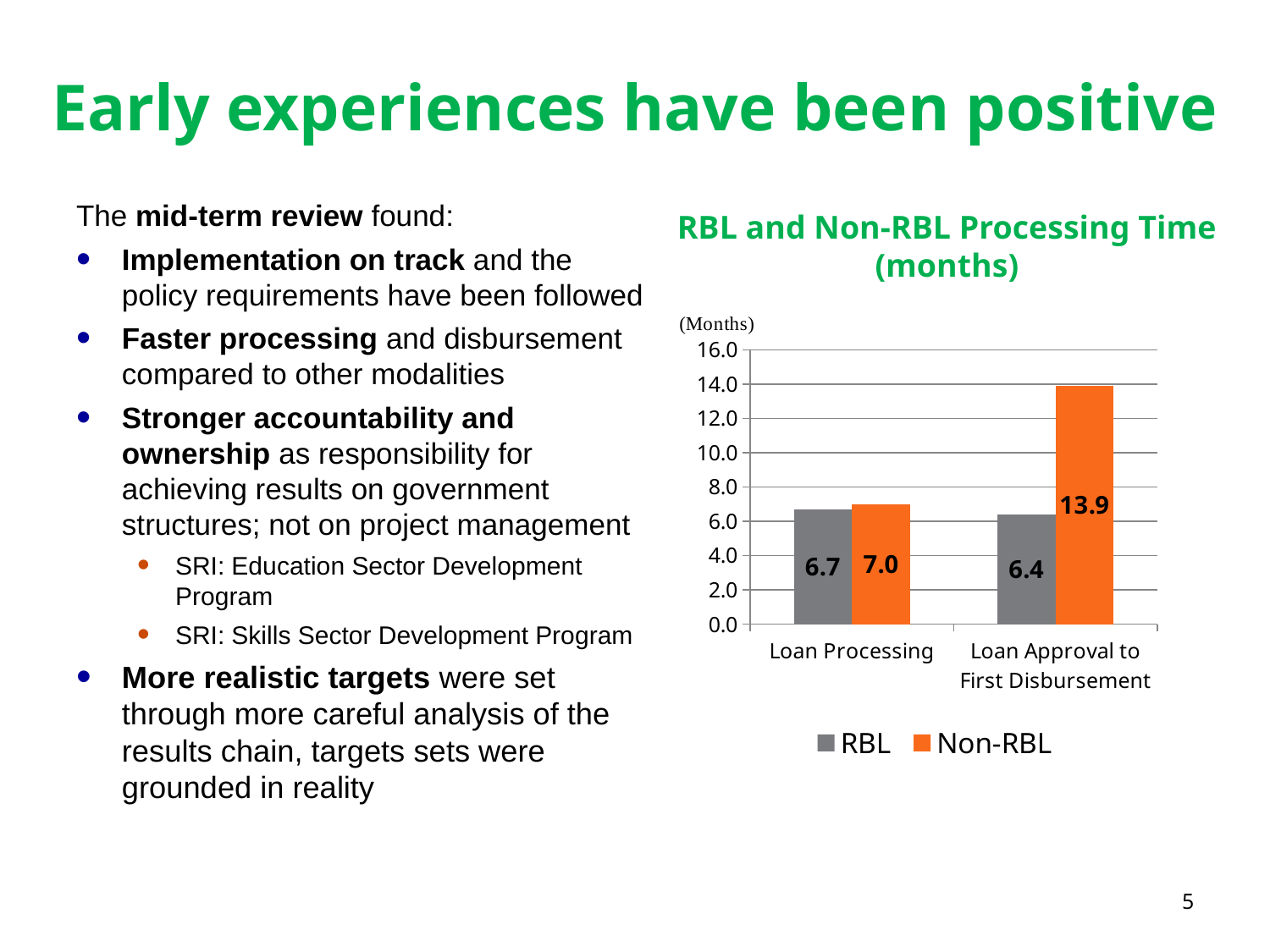
What is the Non-RBL value for Loan Approval to First Disbursement? 13.9 Is the Non-RBL value for Loan Approval to First Disbursement greater or less than 12.0? greater What is the Non-RBL value for Loan Processing? 7.0 How many series does the legend list? 2 What is the difference between the Non-RBL and RBL values for Loan Processing? 0.3 How many categories are shown on the x axis? 2 What kind of chart is shown? bar chart What is the difference between the Non-RBL and RBL values for Loan Approval to First Disbursement? 7.5 What is the RBL value for Loan Approval to First Disbursement? 6.4 What is the RBL value for Loan Processing? 6.7 Which category has the highest Non-RBL value? Loan Approval to First Disbursement Which is larger for Loan Approval to First Disbursement, RBL or Non-RBL? Non-RBL